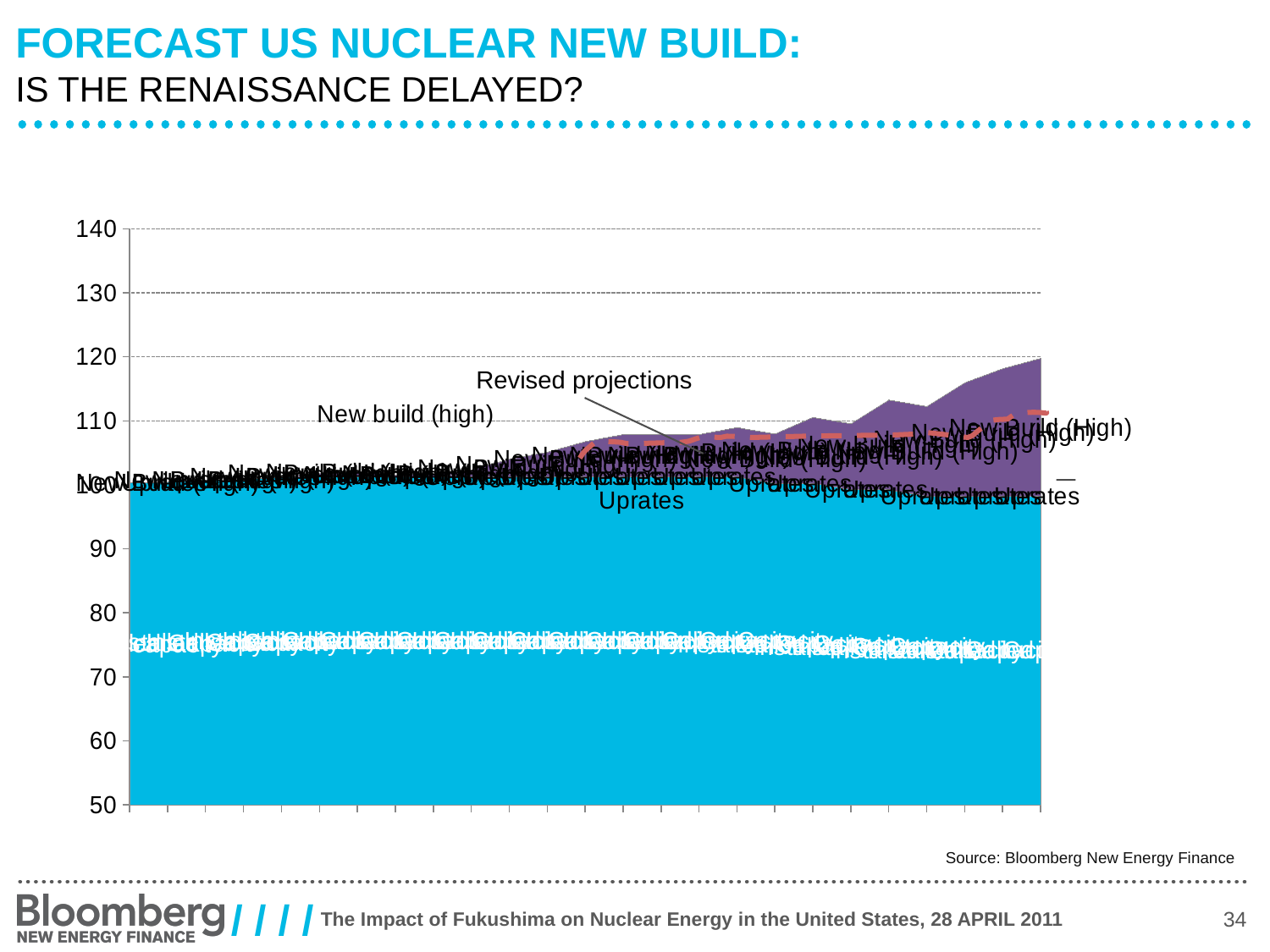
Is the total value at the left end of the chart greater or less than 90? greater What is the highest value shown on the y axis of the chart? 140 What is the lowest value shown on the y axis of the chart? 50 What kind of chart is shown on the slide? area chart Which series forms the upper (purple) area of the stacked chart? New build (high) Is the total value at the left end of the chart greater or less than 110? less Is the highest point reached by the stacked area greater or less than 110? greater Does the total height of the stacked area rise or fall from left to right along the x axis? rises Which series is represented by the dashed line on the chart? Revised projections